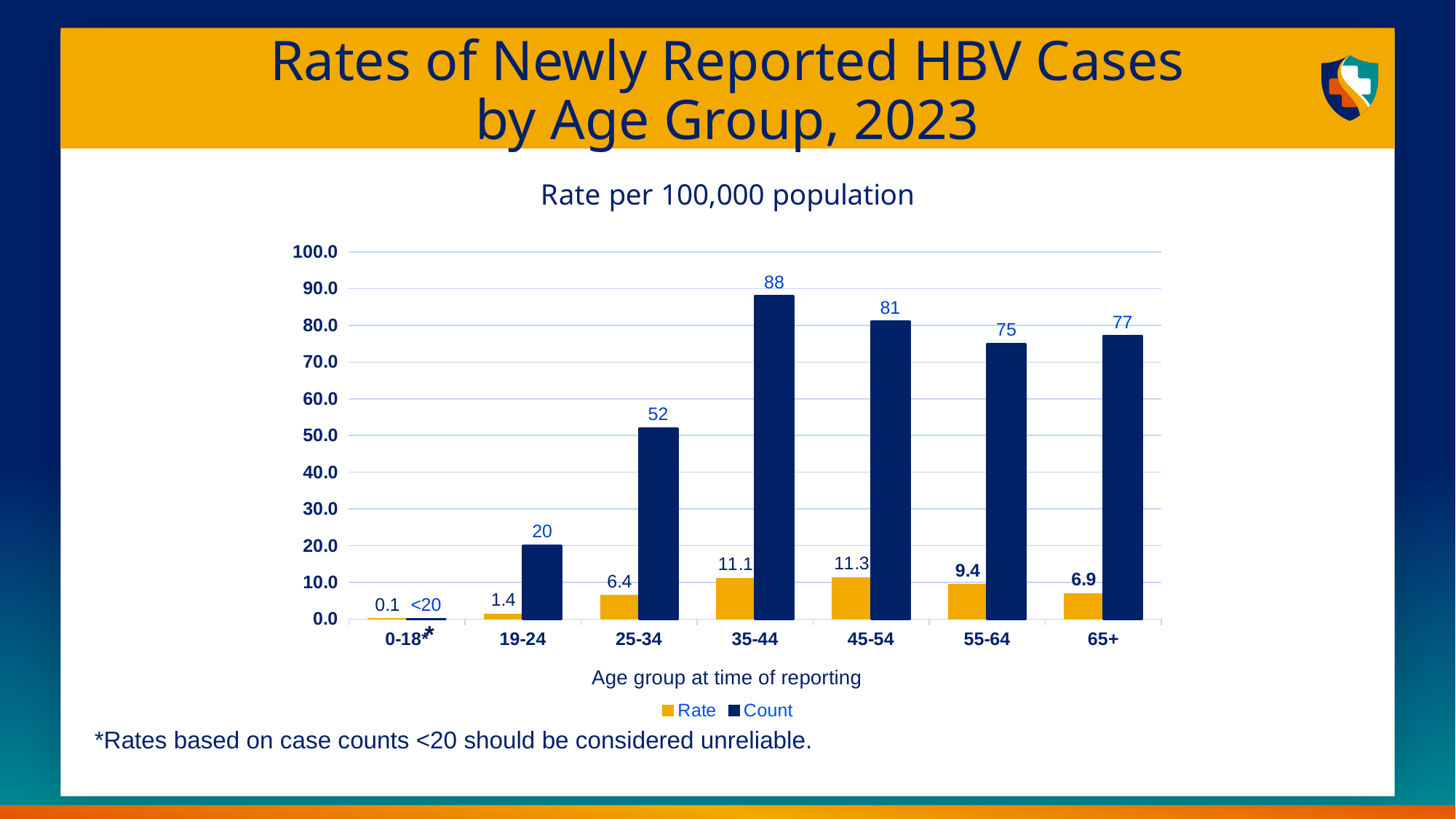
How many series does the legend list? 2 Is the Count for the 65+ age group greater or less than 70? greater How many age groups are shown on the x axis? 7 Which age group has a higher Rate, 55-64 or 65+? 55-64 What is the Count for the 25-34 age group? 52 What is the Rate for the 65+ age group? 6.9 Which age group has the lowest Rate? 0-18 What is the Rate for the 35-44 age group? 11.1 What is the x-axis label of the chart? Age group at time of reporting What is the difference in Count between the 35-44 and 45-54 age groups? 7 What kind of chart is shown on the slide? Bar chart Which age group has the highest Count? 35-44